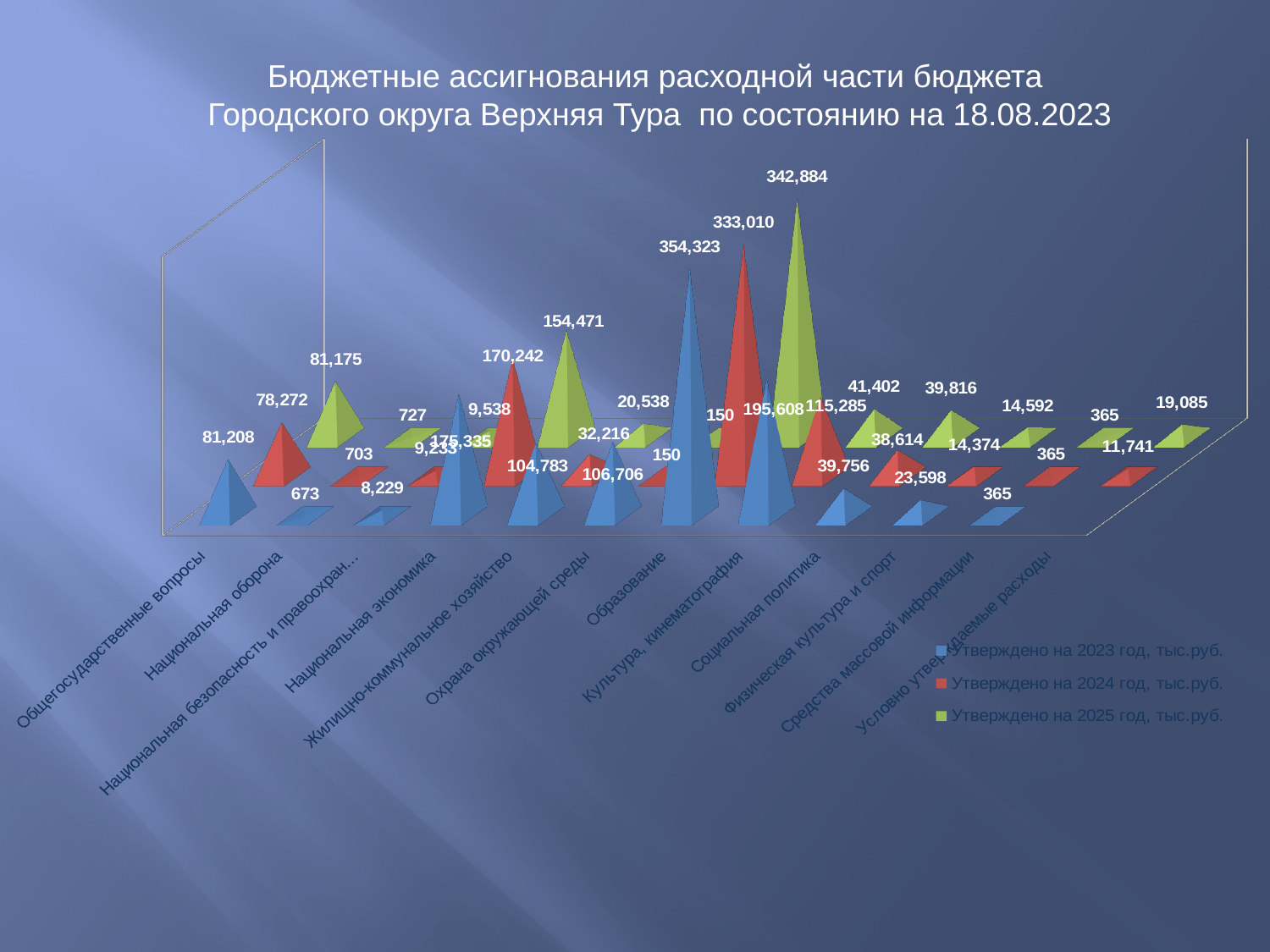
What is the value for Образование in the series Утверждено на 2023 год? 354,323 What is the value for Национальная оборона in the series Утверждено на 2025 год? 727 What is the difference between the 2023 and 2024 values for Общегосударственные вопросы? 2,936 What is the value for Общегосударственные вопросы in the series Утверждено на 2024 год? 78,272 What is the value for Национальная экономика in the series Утверждено на 2023 год? 175,335 How many categories are shown along the x axis? 12 For Национальная экономика, which is larger: the value for 2023 or the value for 2024? 2023 What is the difference between the 2023 and 2024 values for Образование? 21,313 Which colour represents the series Утверждено на 2025 год, тыс.руб.? green How many series does the legend list? 3 What kind of chart is shown on the slide? bar chart Which category has the highest value in the series Утверждено на 2023 год? Образование